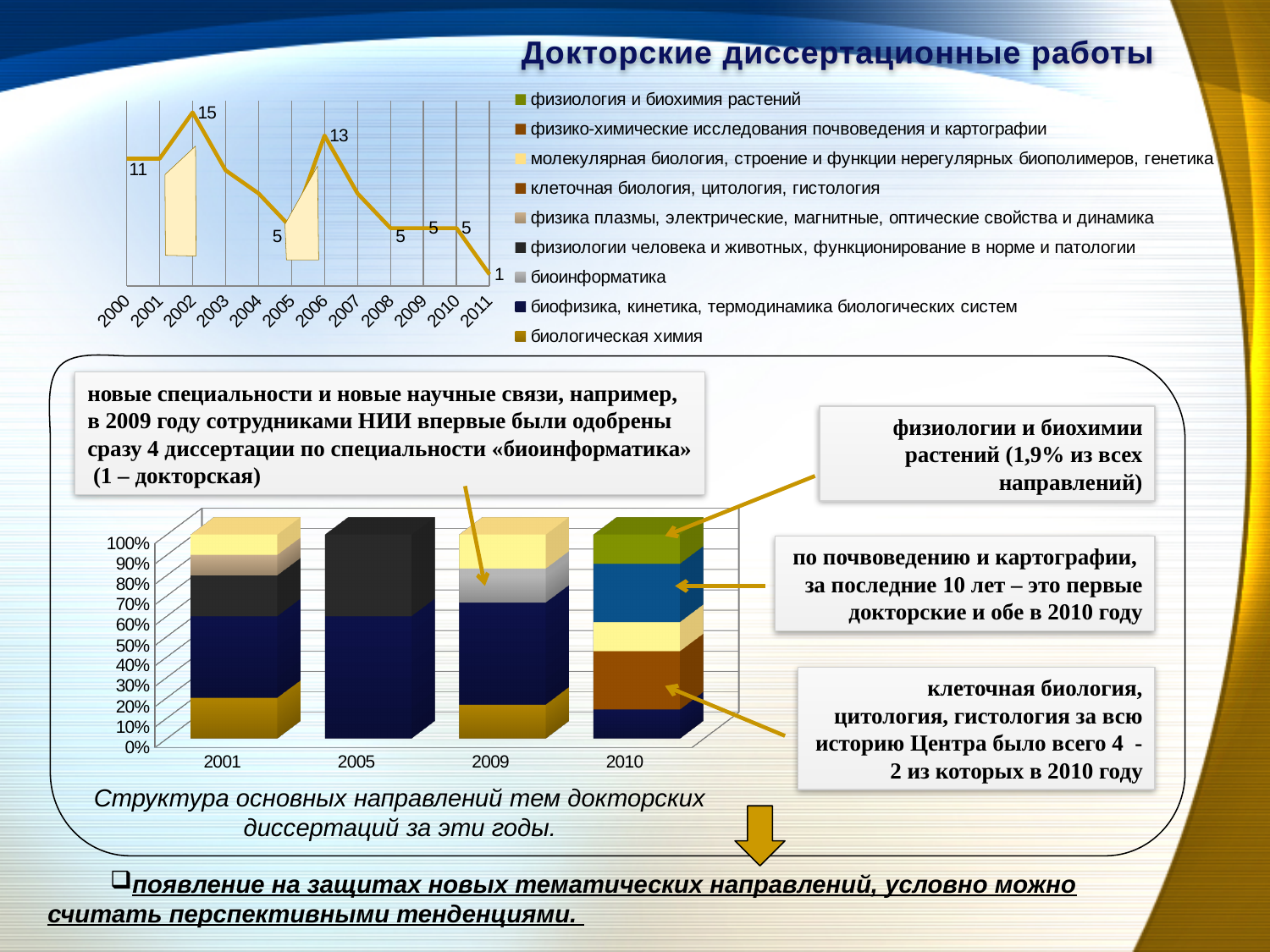
On the line chart at the top left, which year has the highest value? 2002 On the line chart at the top left, do the values rise or fall from 2006 to 2011? fall On the line chart at the top left, what is the value for 2011? 1 On the line chart at the top left, what is the value for 2002? 15 On the line chart at the top left, which year has the lowest value? 2011 On the line chart at the top left, what is the value for 2009? 5 What kind of chart is the chart at the bottom of the slide with years 2001, 2005, 2009 and 2010? stacked bar chart How many entries does the legend at the top right of the slide list? 9 On the line chart at the top left, which is larger, the value for 2006 or the value for 2010? 2006 On the line chart at the top left, what is the difference between the values for 2002 and 2006? 2 On the line chart at the top left, what is the value for 2006? 13 On the line chart at the top left, how many years are shown on the x axis? 12